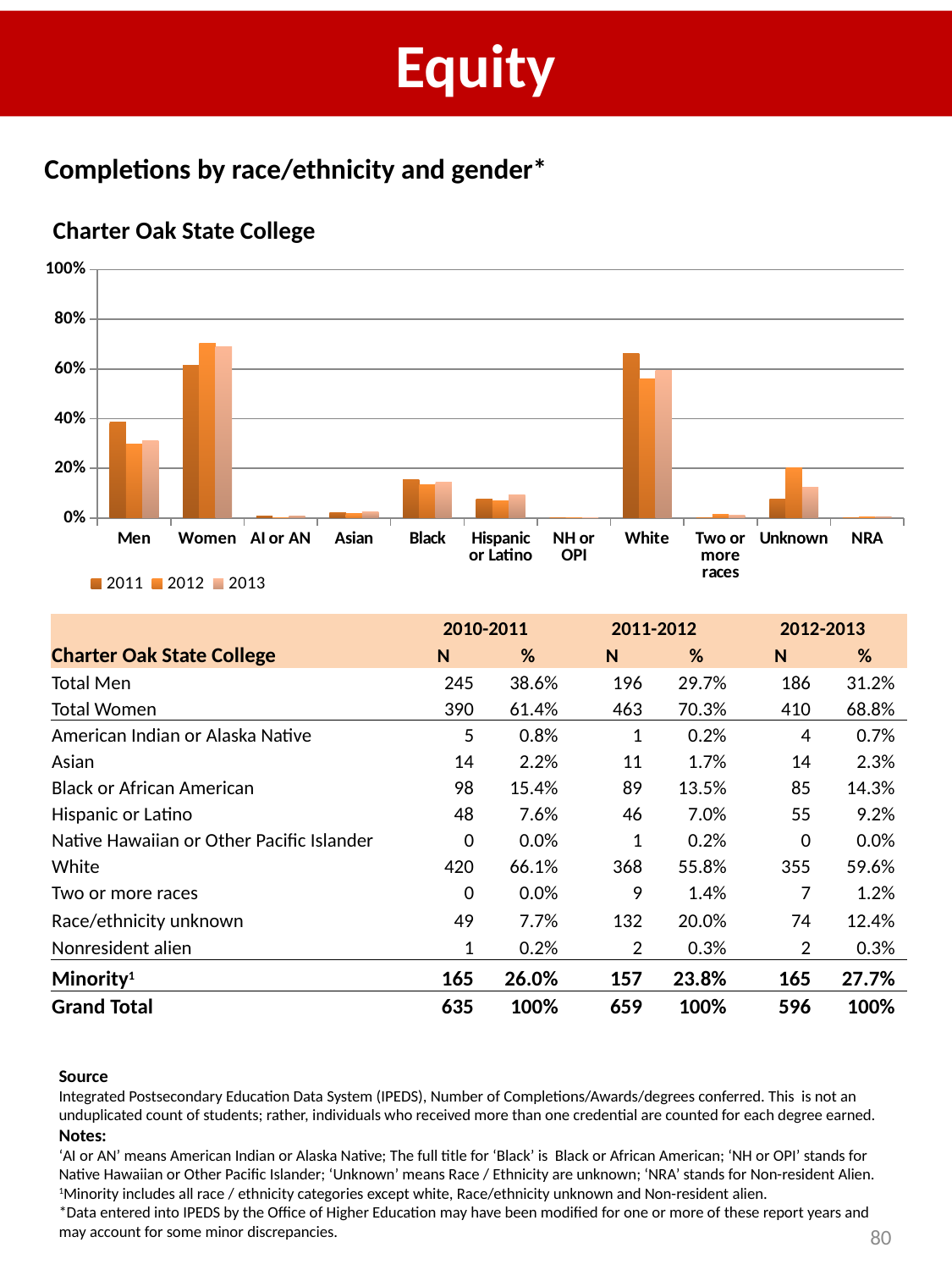
What is the title of the chart? Charter Oak State College How many series does the chart legend list? 3 Which category has the highest bar for 2012? Women Which category has the highest bar for 2013? Women Is the 2012 value for Women greater or less than 60%? greater Is the 2012 value for White greater or less than 60%? less Is the 2011 value for Black greater or less than 20%? less In 2011, which is larger: the value for Black or the value for Hispanic or Latino? Black According to the table, what percentage of completions in 2011-2012 were by women? 70.3% What kind of chart is shown on the slide? bar chart How many categories are shown along the x axis of the chart? 11 In 2012, which is larger: the value for Unknown or the value for Black? Unknown